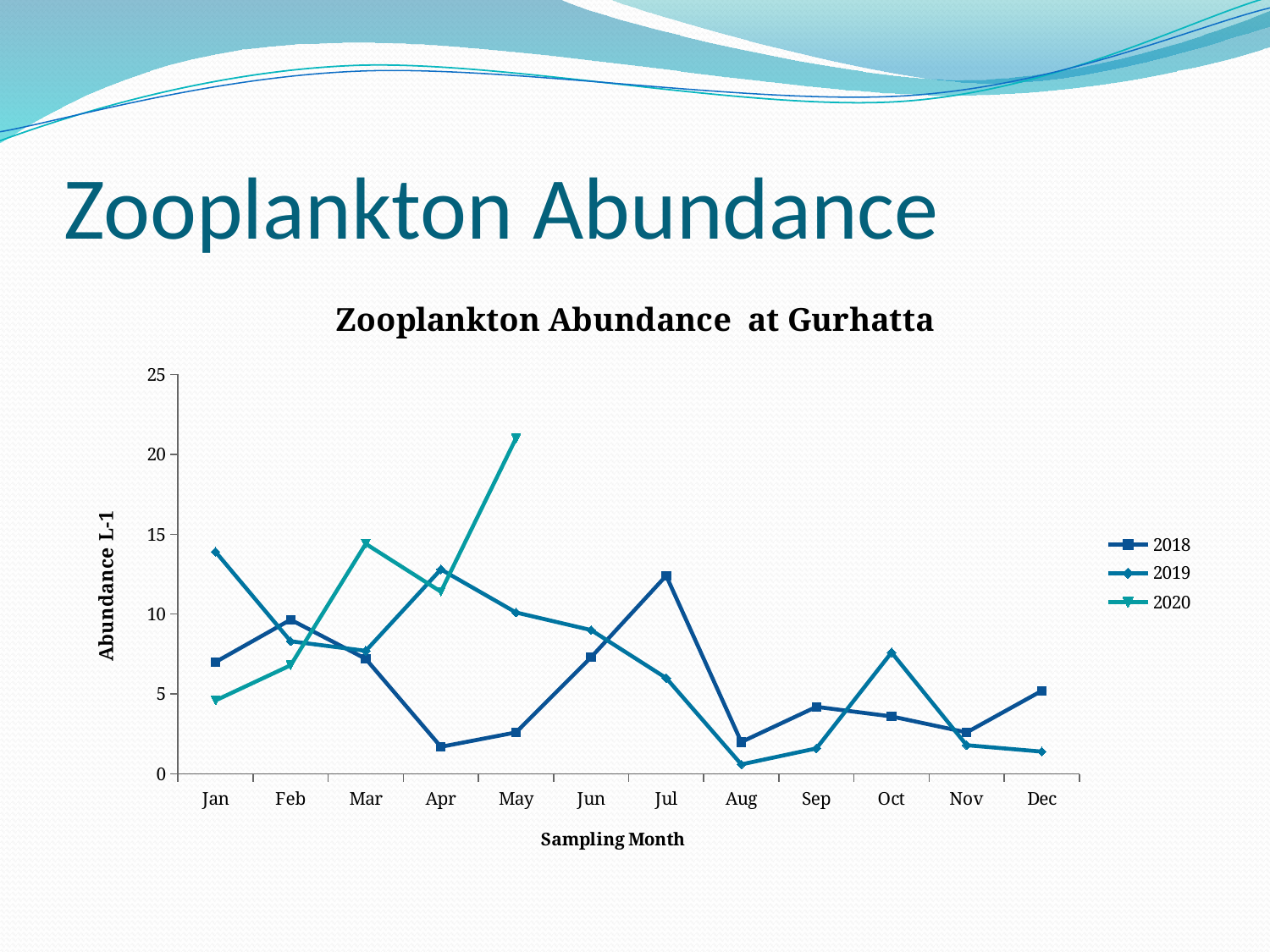
Does the 2020 series rise or fall from Apr to May? rise In which month does the 2018 series reach its highest value? Jul Is the value for 2018 in Apr greater or less than 5? less What kind of chart is shown on the slide? line chart Is the value for 2020 in May greater or less than 20? greater In which month does the 2020 series reach its highest value? May In Jan, which series has the larger value, 2018 or 2019? 2019 In which month does the 2019 series reach its highest value? Jan What is the title of the y axis? Abundance L-1 In which month does the 2019 series reach its lowest value? Aug How many sampling months are shown on the x axis? 12 How many series does the legend list? 3